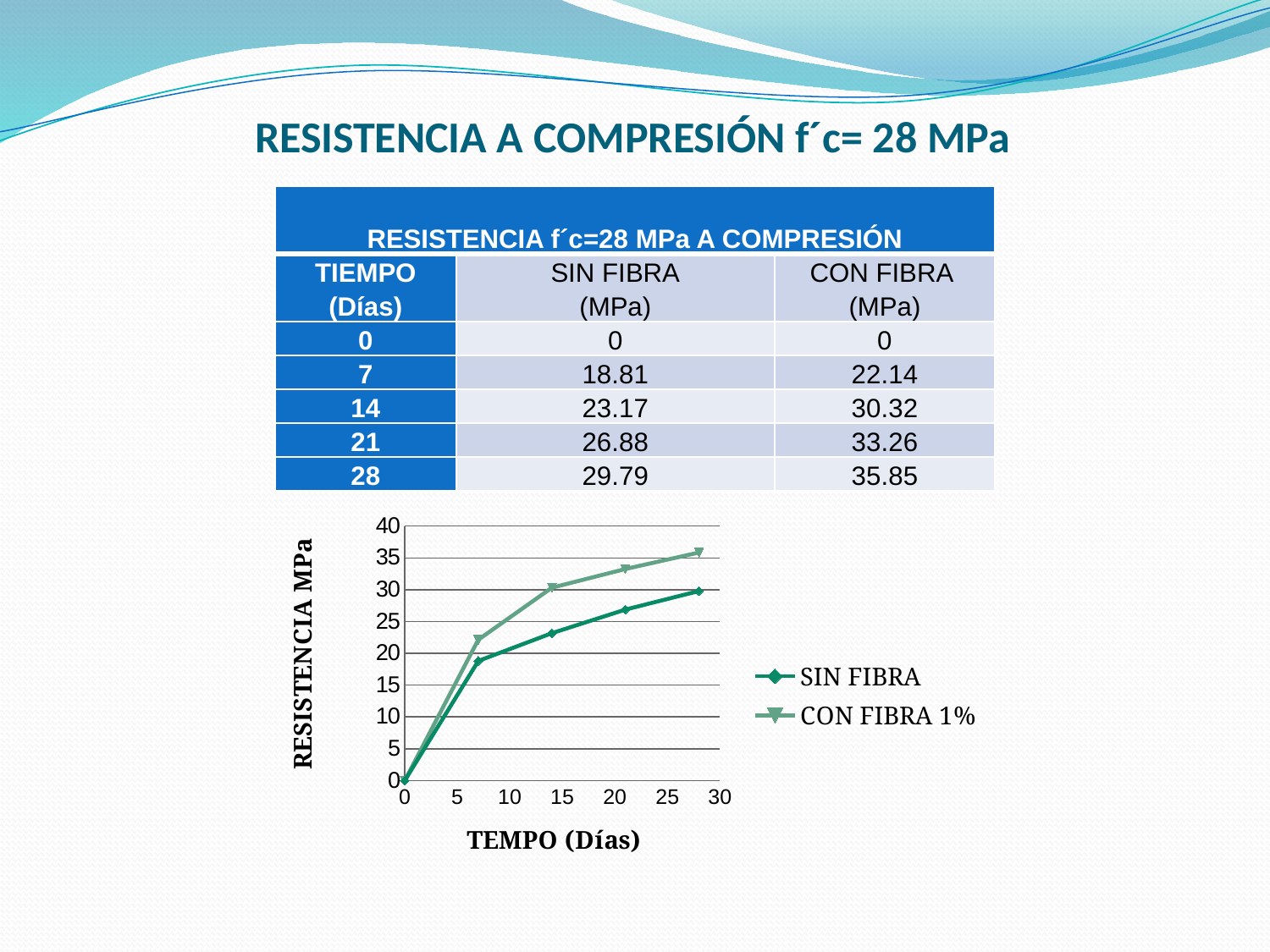
Which series has the higher value at 28 days, SIN FIBRA or CON FIBRA? CON FIBRA Is the value of the SIN FIBRA series at 7 days greater or less than 20? less Do the values of the SIN FIBRA series rise or fall as time increases along the x axis? rise According to the table, what is the SIN FIBRA resistance at 28 days? 29.79 Is the value of the CON FIBRA 1% series at 14 days greater or less than 25? greater How many data points are plotted for each series in the chart? 5 What is the label of the chart's y axis? RESISTENCIA MPa How many series does the chart legend list? 2 What are the two series named in the chart legend? SIN FIBRA and CON FIBRA 1% What kind of chart is shown on the slide? line chart Using the table values, what is the difference between CON FIBRA and SIN FIBRA resistance at 28 days? 6.06 According to the table, what is the CON FIBRA resistance at 14 days? 30.32